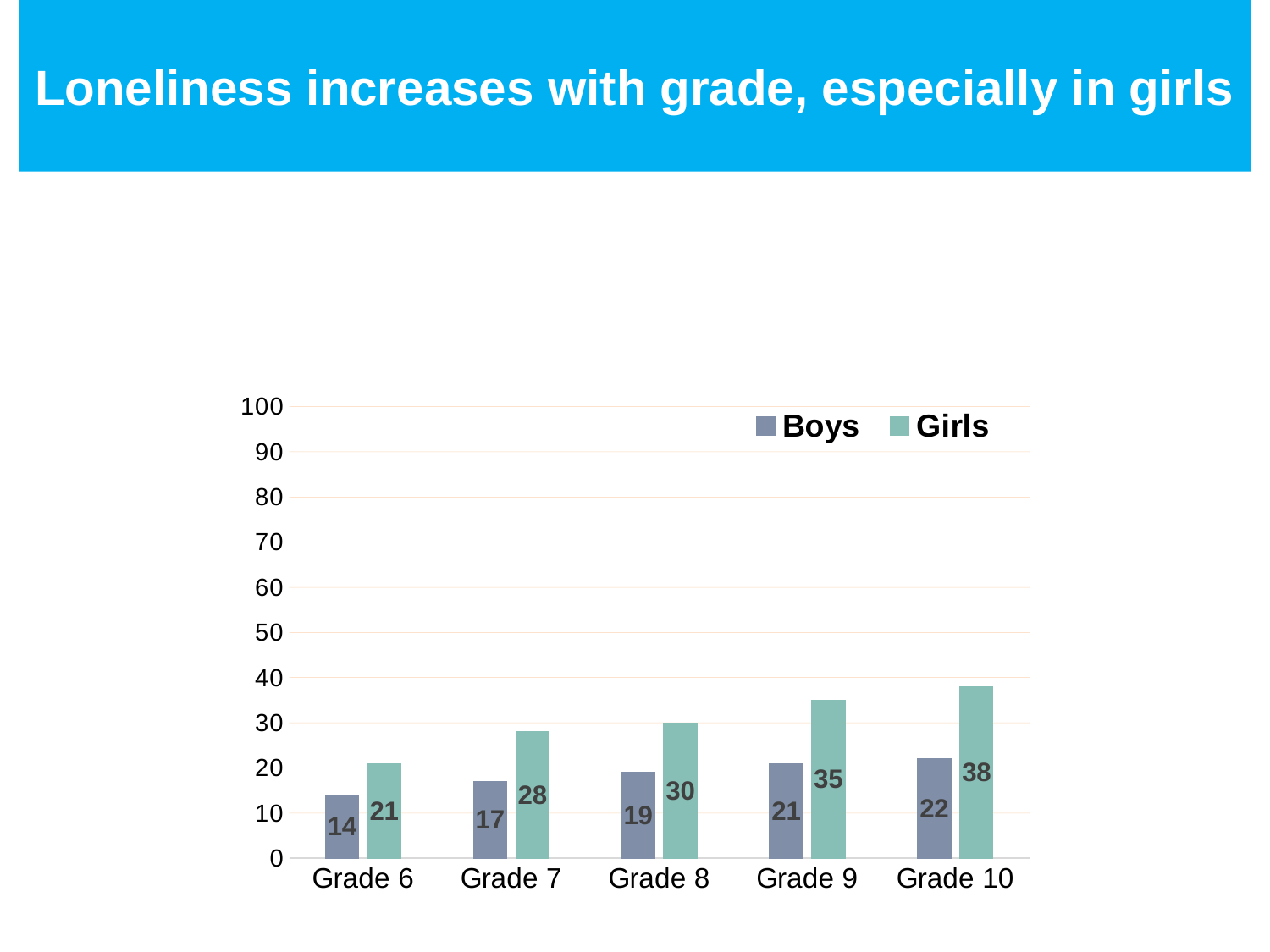
Do the values for Girls rise or fall from Grade 6 to Grade 10? Rise Which is larger in Grade 7, the value for Boys or the value for Girls? Girls What is the difference between the Girls and Boys values in Grade 9? 14 Is the value for Girls in Grade 10 greater or less than 30? greater What is the value for Girls in Grade 8? 30 Which grade has the lowest value for Boys? Grade 6 What is the value for Boys in Grade 6? 14 What is the value for Boys in Grade 10? 22 What kind of chart is shown on the slide? Bar chart How many grade categories are shown on the x axis? 5 How many series does the legend list? 2 Which grade has the highest value for Girls? Grade 10